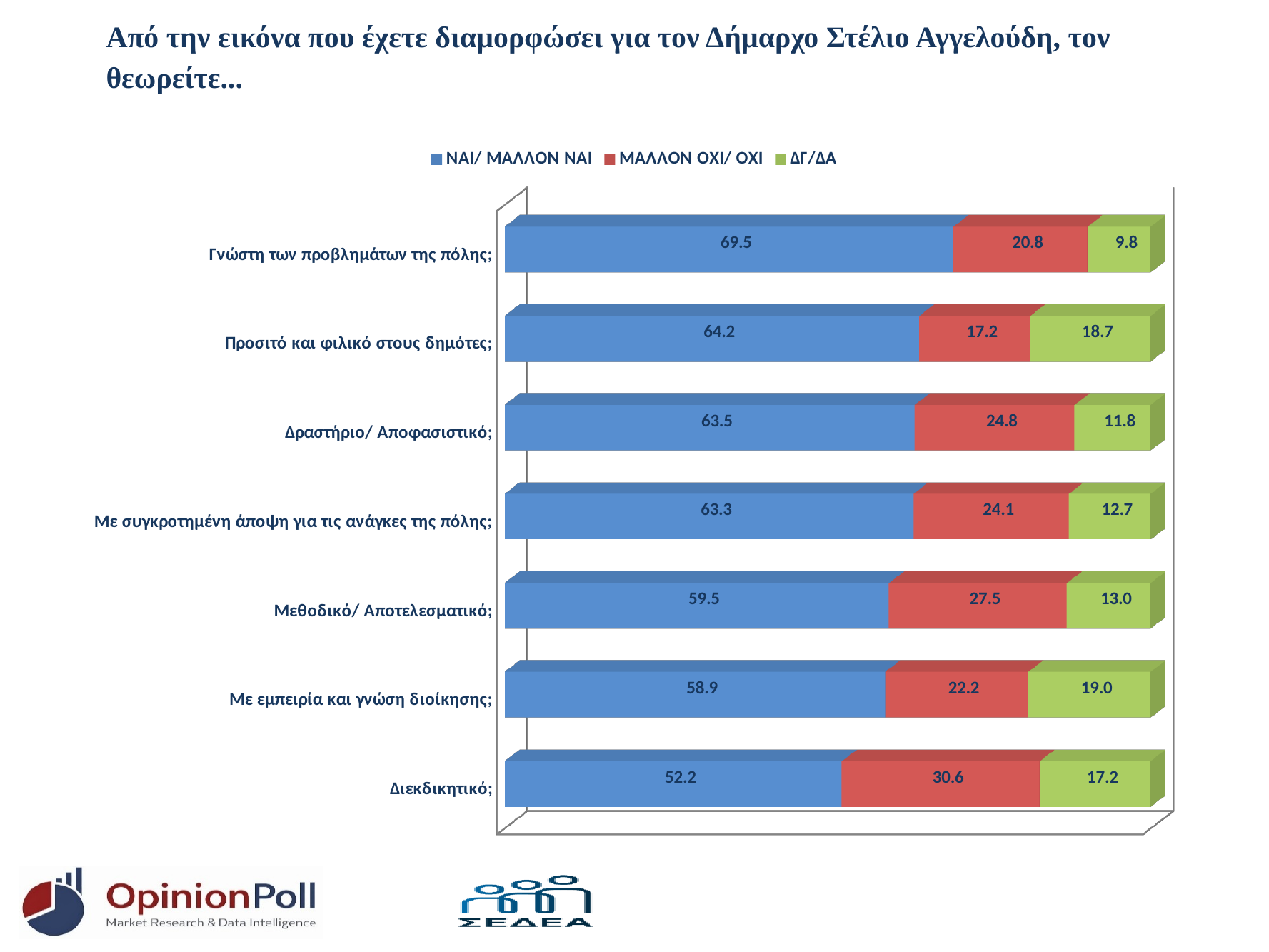
How many series does the legend list? 3 What kind of chart is shown on the slide? Stacked bar chart How many categories are shown in the chart? 7 What is the value of ΜΑΛΛΟΝ ΟΧΙ/ ΟΧΙ for 'Διεκδικητικό'? 30.6 What is the total of the stacked bar for 'Μεθοδικό/ Αποτελεσματικό'? 100.0 What is the ΔΓ/ΔΑ value for 'Προσιτό και φιλικό στους δημότες'? 18.7 Which category has the highest ΜΑΛΛΟΝ ΟΧΙ/ ΟΧΙ value? Διεκδικητικό Which category has the highest ΝΑΙ/ ΜΑΛΛΟΝ ΝΑΙ value? Γνώστη των προβλημάτων της πόλης What is the difference between the ΝΑΙ/ ΜΑΛΛΟΝ ΝΑΙ values for 'Γνώστη των προβλημάτων της πόλης' and 'Διεκδικητικό'? 17.3 Which category has the lowest ΝΑΙ/ ΜΑΛΛΟΝ ΝΑΙ value? Διεκδικητικό Which is larger: the ΔΓ/ΔΑ value for 'Με εμπειρία και γνώση διοίκησης' or for 'Μεθοδικό/ Αποτελεσματικό'? Με εμπειρία και γνώση διοίκησης What is the value of ΝΑΙ/ ΜΑΛΛΟΝ ΝΑΙ for 'Γνώστη των προβλημάτων της πόλης'? 69.5